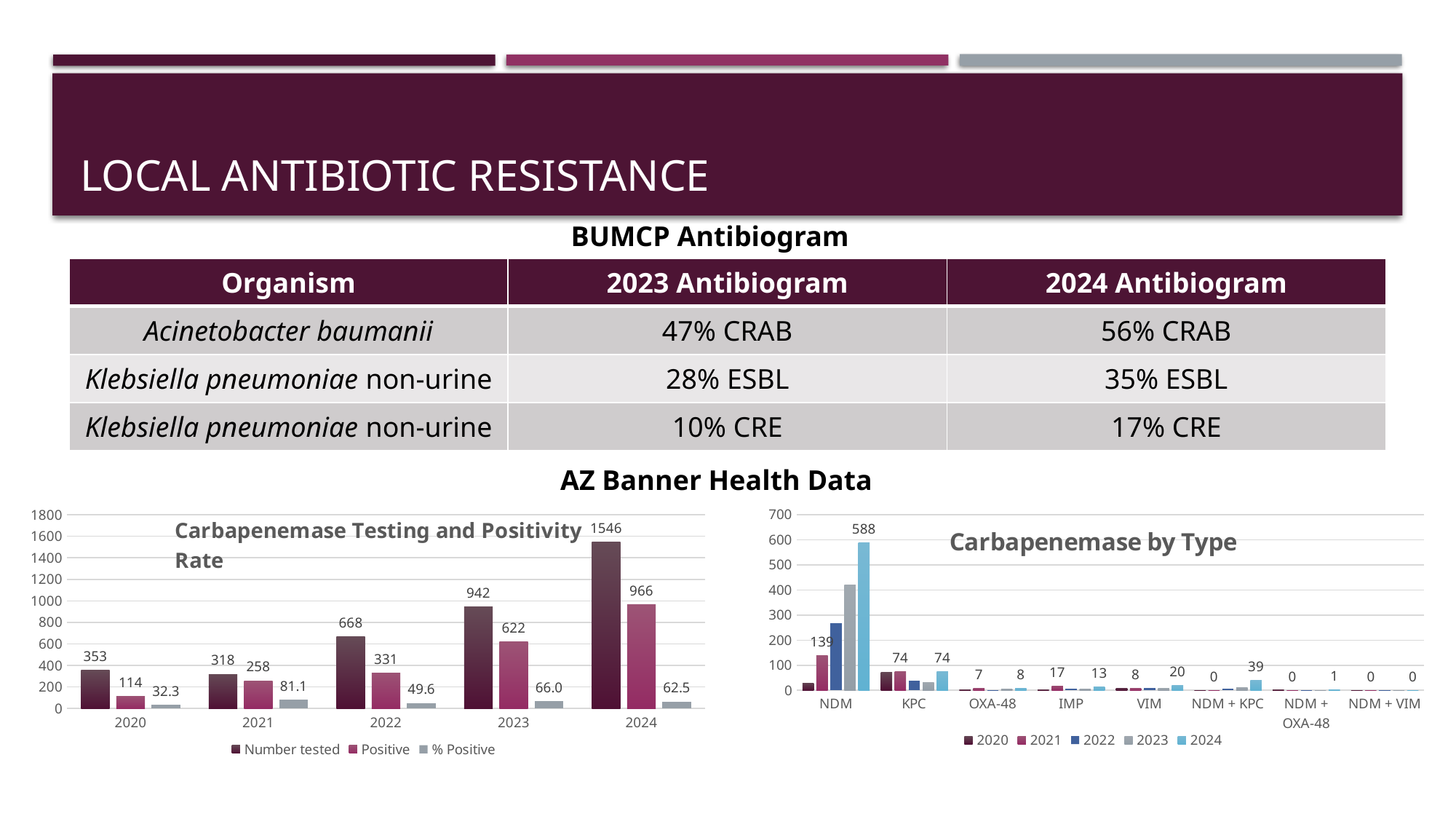
In the Carbapenemase Testing and Positivity Rate chart, does the Number tested series rise or fall from 2021 to 2024? rise In the Carbapenemase by Type chart, which type has the highest 2024 value? NDM In the Carbapenemase by Type chart, how many series does the legend list? 5 In the Carbapenemase by Type chart, what is the 2024 value for NDM? 588 In the Carbapenemase by Type chart, what is the 2024 value for NDM + KPC? 39 In the Carbapenemase by Type chart, is the 2023 value for NDM greater or less than 300? greater In the Carbapenemase Testing and Positivity Rate chart, what is the difference between Number tested and Positive in 2023? 320 In the Carbapenemase Testing and Positivity Rate chart, which year has the highest % Positive value? 2021 In the Carbapenemase Testing and Positivity Rate chart, what is the Positive value for 2022? 331 In the Carbapenemase Testing and Positivity Rate chart, what is the Number tested value for 2024? 1546 In the Carbapenemase Testing and Positivity Rate chart, how many years are shown on the x axis? 5 What kind of chart is the Carbapenemase by Type chart? bar chart